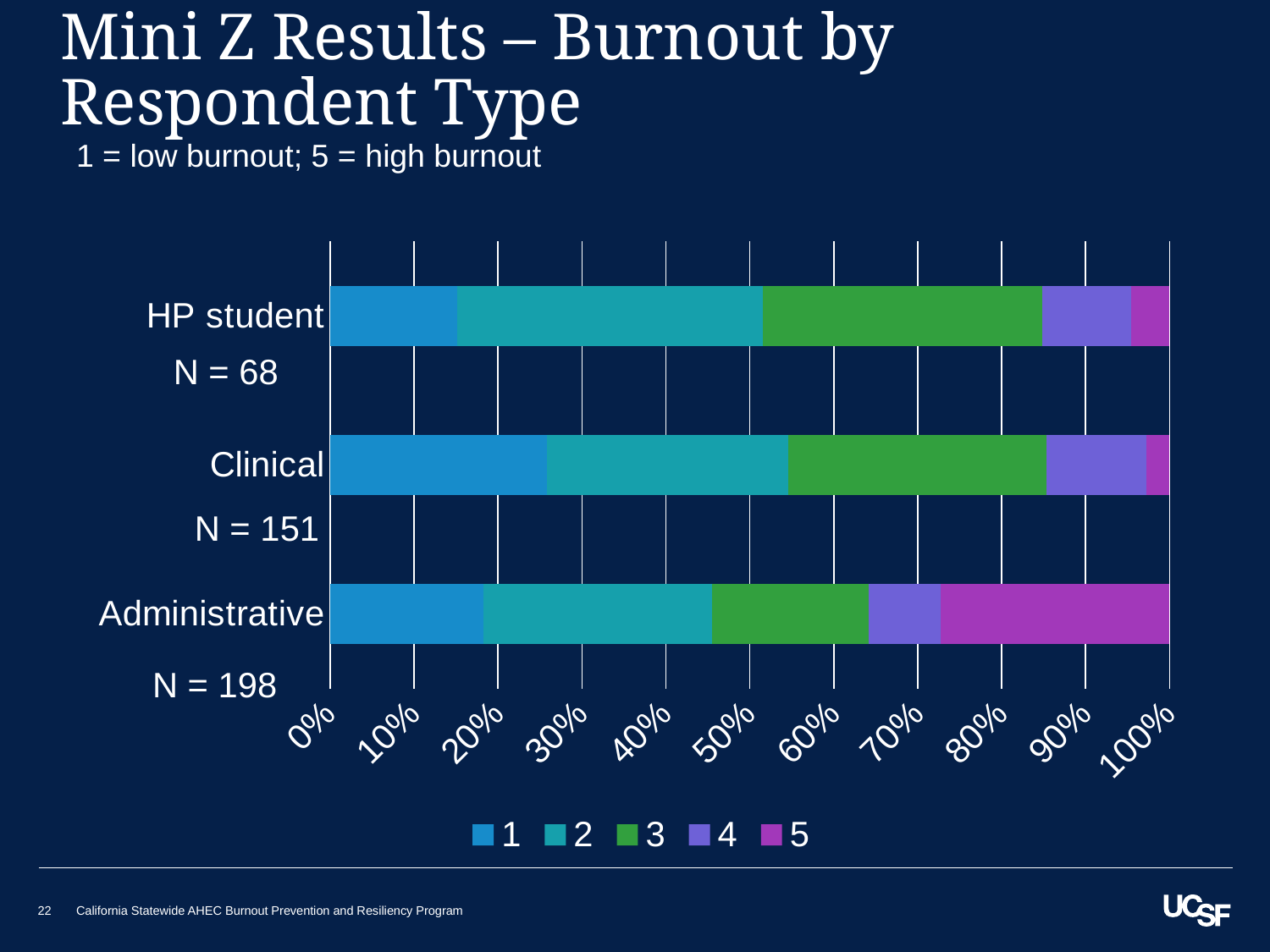
Is the share of HP student respondents rating burnout 1 greater or less than 20%? less How many series does the legend list? 5 Which respondent type has the largest share of respondents rating burnout 5? Administrative What is the N for the HP student respondent type? 68 Is the share of Clinical respondents rating burnout 1 greater or less than 20%? greater Which respondent type has the largest share of respondents rating burnout 1? Clinical What is the N for the Administrative respondent type? 198 What kind of chart is shown on the slide? Stacked bar chart How many respondent types are shown on the chart? 3 Which respondent type has the smallest share of respondents rating burnout 3? Administrative What is the N for the Clinical respondent type? 151 According to the subtitle, what does a rating of 5 represent? high burnout